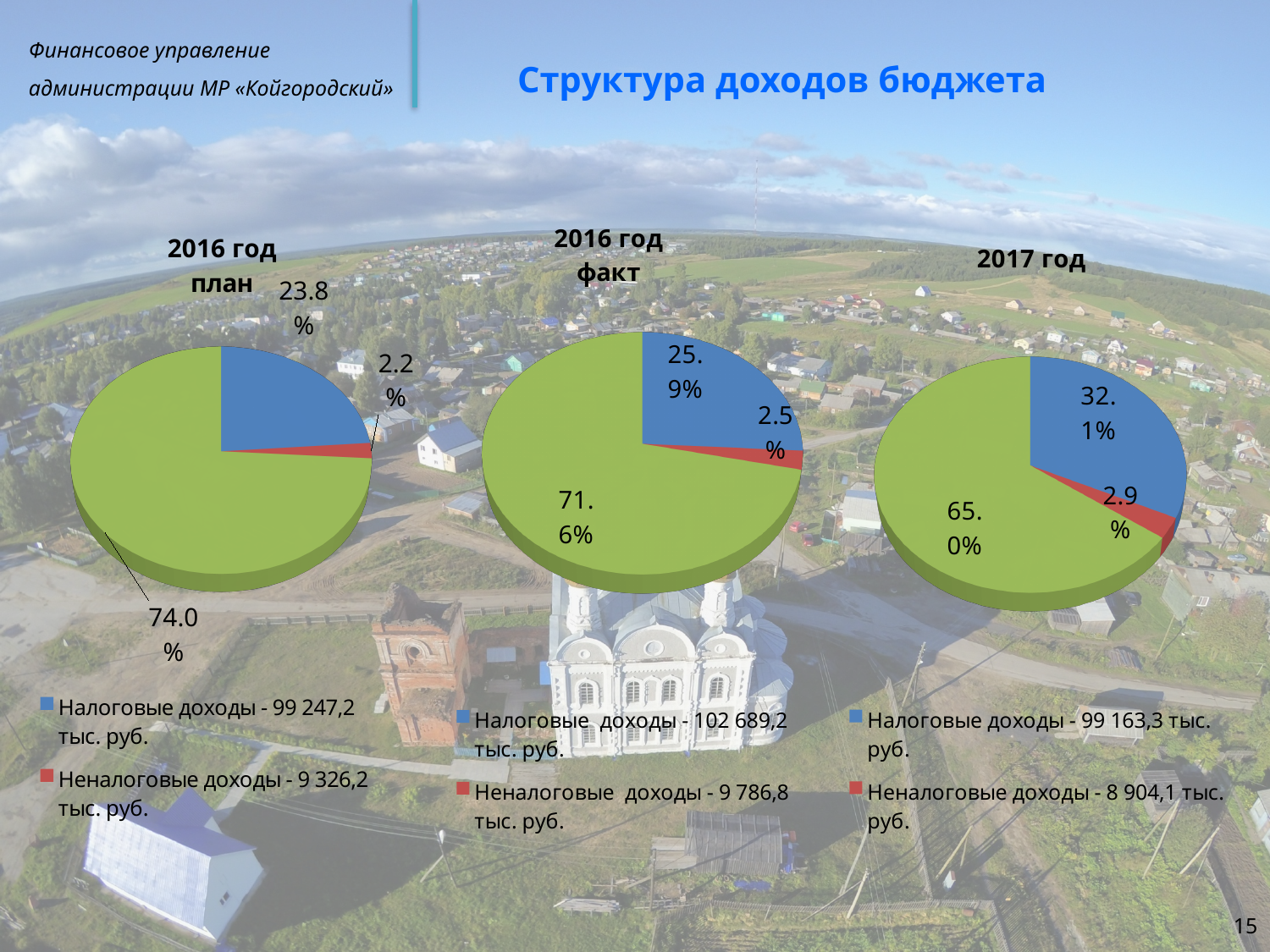
In the "2016 год план" chart, which legend category has the smallest slice? Неналоговые доходы In the legend of the "2016 год план" chart, what amount is given for Налоговые доходы? 99 247,2 тыс. руб. In the "2016 год план" chart, what share is shown for Налоговые доходы? 23.8% In the "2017 год" chart, what share is shown for Налоговые доходы? 32.1% In the "2016 год факт" chart, what share is shown for Неналоговые доходы? 2.5% What type of chart is used for the "2016 год план" chart? Pie chart How many entries does the legend under the "2017 год" chart list? 2 Is the share of Налоговые доходы larger in the "2016 год факт" chart or in the "2017 год" chart? 2017 год In the "2017 год" chart, what is the difference between the Налоговые доходы share and the Неналоговые доходы share? 29.2 percentage points In the "2016 год факт" chart, what colour represents Неналоговые доходы? Red How many slices does the "2016 год факт" pie chart have? 3 In the "2017 год" chart, what is the value of the largest slice? 65.0%